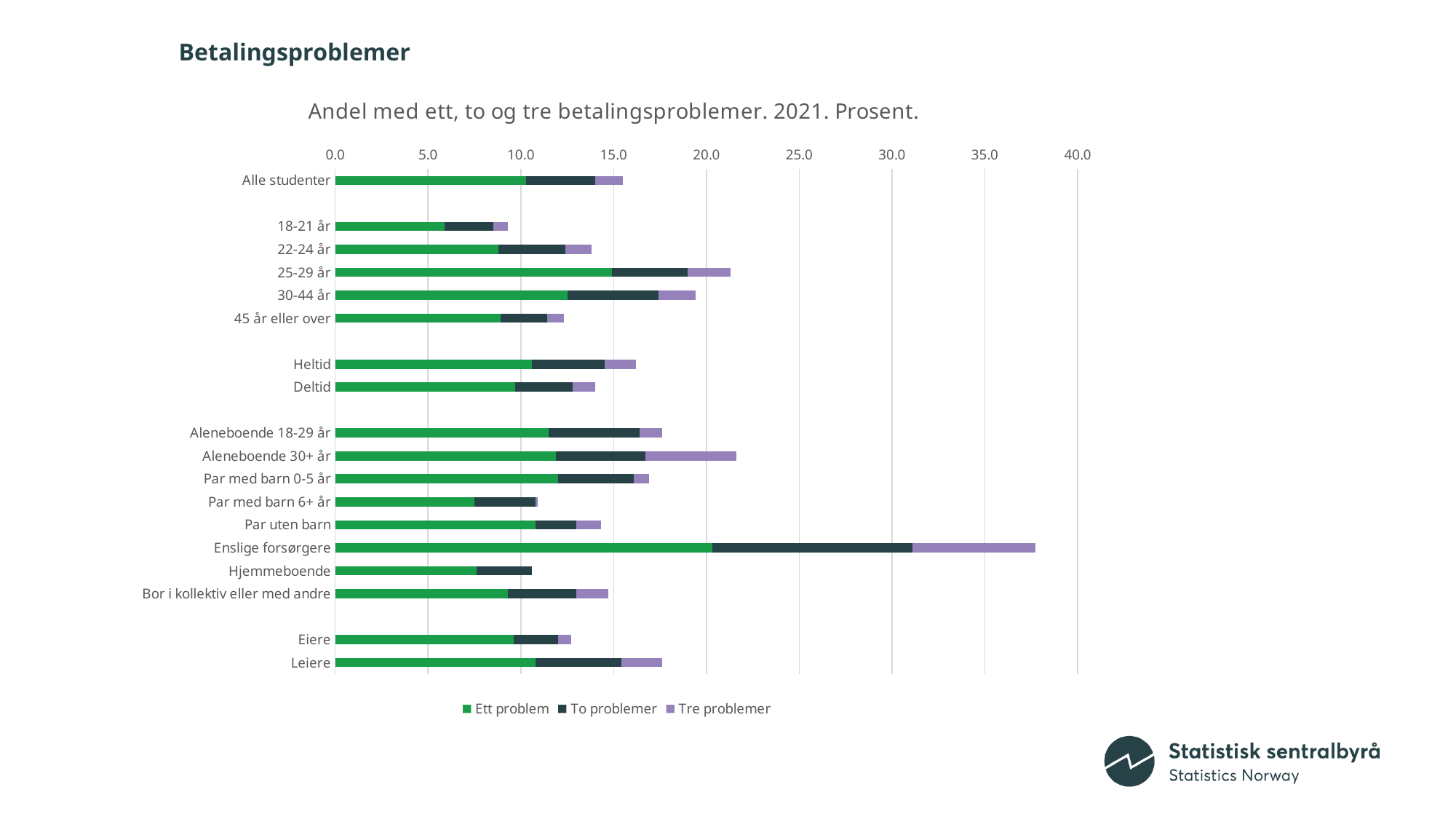
Which category has the lowest total share of payment problems? 18-21 år Is the total value for Hjemmeboende greater or less than 15.0? less Is the total value for Aleneboende 30+ år greater or less than 20.0? greater How many series does the legend list? 3 What kind of chart is shown on the slide? Stacked bar chart Which has a larger total share of payment problems, Leiere or Eiere? Leiere How many categories are plotted on the chart? 18 Which age group has the highest total share of payment problems? 25-29 år Is the total value for Enslige forsørgere greater or less than 35.0? greater Which category has the highest total share of payment problems? Enslige forsørgere What is the title of the chart? Andel med ett, to og tre betalingsproblemer. 2021. Prosent.